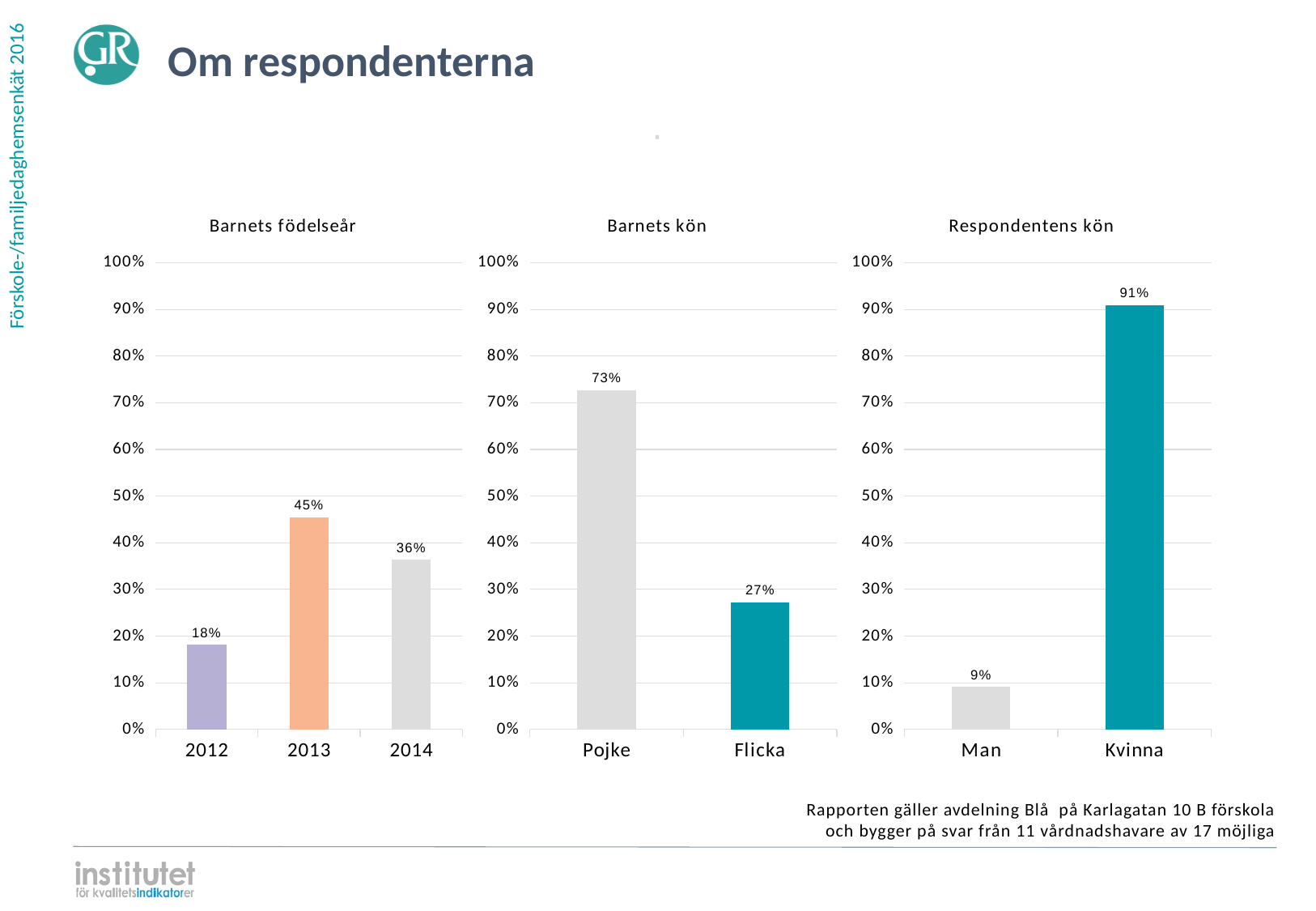
In the 'Barnets födelseår' chart, what is the difference between the values for 2013 and 2014? 9% In the 'Barnets födelseår' chart, how many categories are shown on the x axis? 3 In the 'Respondentens kön' chart, which category has the highest value? Kvinna What kind of chart is the 'Barnets kön' chart? Bar chart In the 'Respondentens kön' chart, what is the value for Man? 9% In the 'Barnets kön' chart, which is larger, Pojke or Flicka? Pojke How many charts are shown on the slide? 3 In the 'Barnets födelseår' chart, what is the value for 2013? 45% In the 'Respondentens kön' chart, is the value for Kvinna greater or less than 80%? greater In the 'Barnets kön' chart, what is the difference between Pojke and Flicka? 46% In the 'Barnets födelseår' chart, which year has the lowest value? 2012 In the 'Barnets kön' chart, what is the value for Pojke? 73%